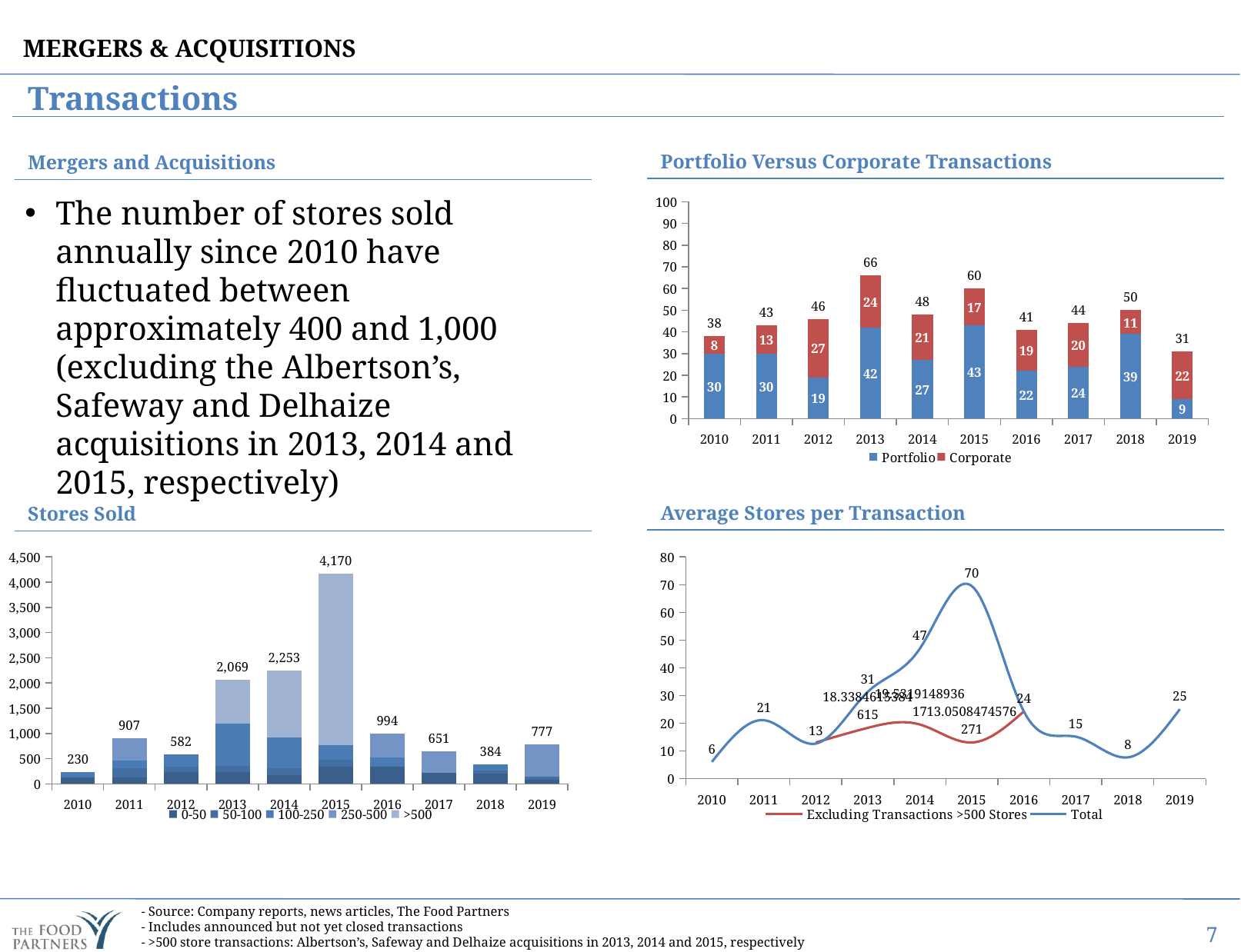
In the Stores Sold chart, how many stores were sold in 2015? 4,170 In the Portfolio Versus Corporate Transactions chart, which is larger in 2019, Portfolio or Corporate? Corporate In the Portfolio Versus Corporate Transactions chart, how many Corporate transactions were there in 2012? 27 In the Portfolio Versus Corporate Transactions chart, what is the total number of transactions in 2013? 66 In the Portfolio Versus Corporate Transactions chart, what is the difference between Portfolio and Corporate transactions in 2018? 28 In the Portfolio Versus Corporate Transactions chart, which year has the lowest total number of transactions? 2019 In the Average Stores per Transaction chart, does the Total line rise or fall from 2015 to 2018? Fall In the Average Stores per Transaction chart, what kind of chart is shown? Line chart In the Stores Sold chart, which year has the fewest stores sold? 2010 In the Stores Sold chart, how many series does the legend list? 5 In the Average Stores per Transaction chart, what is the Total value for 2015? 70 In the Stores Sold chart, what is the difference in stores sold between 2014 and 2013? 184